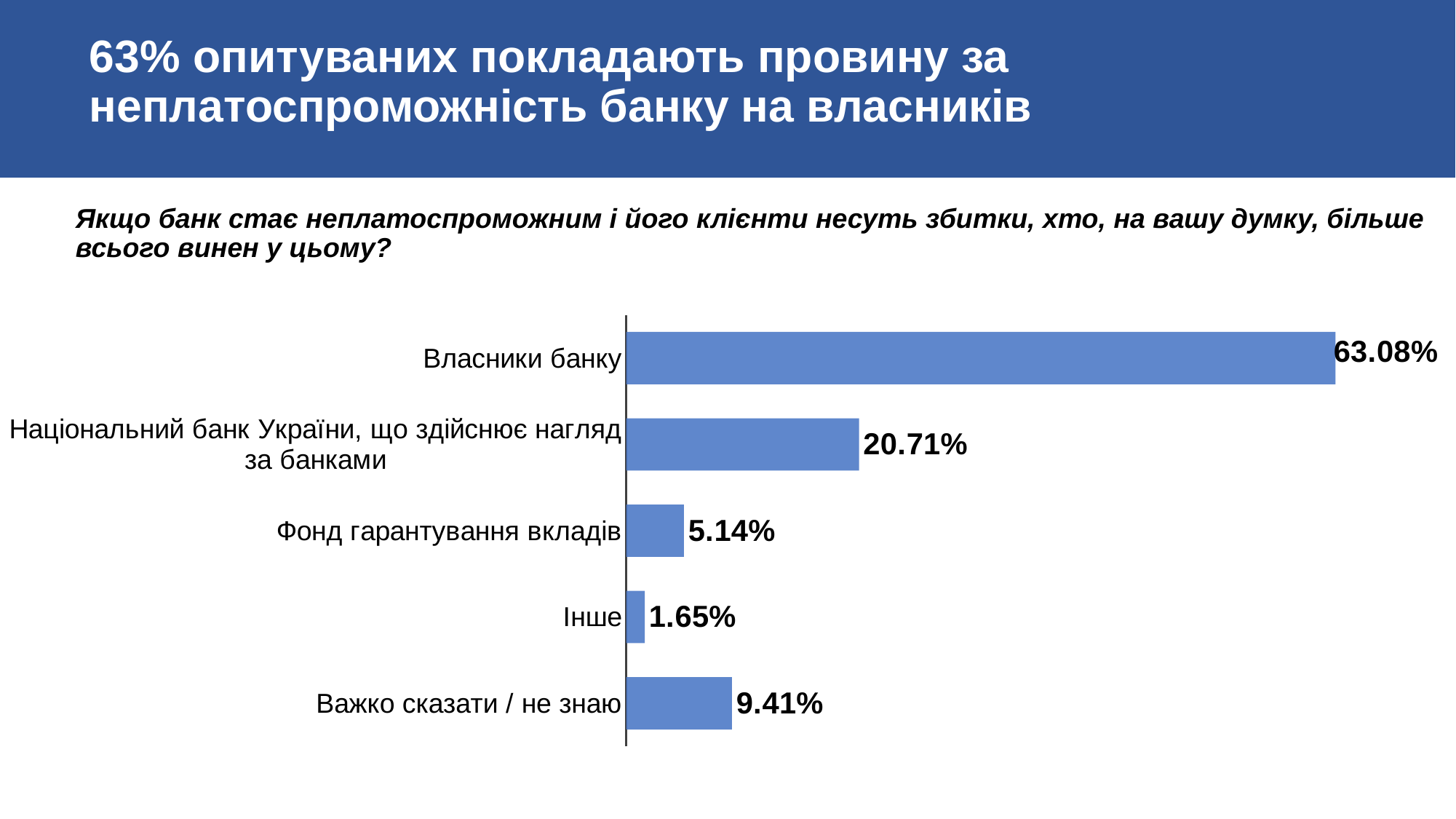
What is the value for Власники банку? 63.08% What is the difference between the values for Важко сказати / не знаю and Інше? 7.76% Which category has the lowest value? Інше Which is larger: the value for Важко сказати / не знаю or the value for Фонд гарантування вкладів? Важко сказати / не знаю What is the value for Національний банк України, що здійснює нагляд за банками? 20.71% What is the value for Важко сказати / не знаю? 9.41% What is the difference between the values for Власники банку and Національний банк України, що здійснює нагляд за банками? 42.37% What is the value for Інше? 1.65% What is the value for Фонд гарантування вкладів? 5.14% How many categories are shown in the chart? 5 Which category has the highest value? Власники банку What kind of chart is shown on the slide? Bar chart